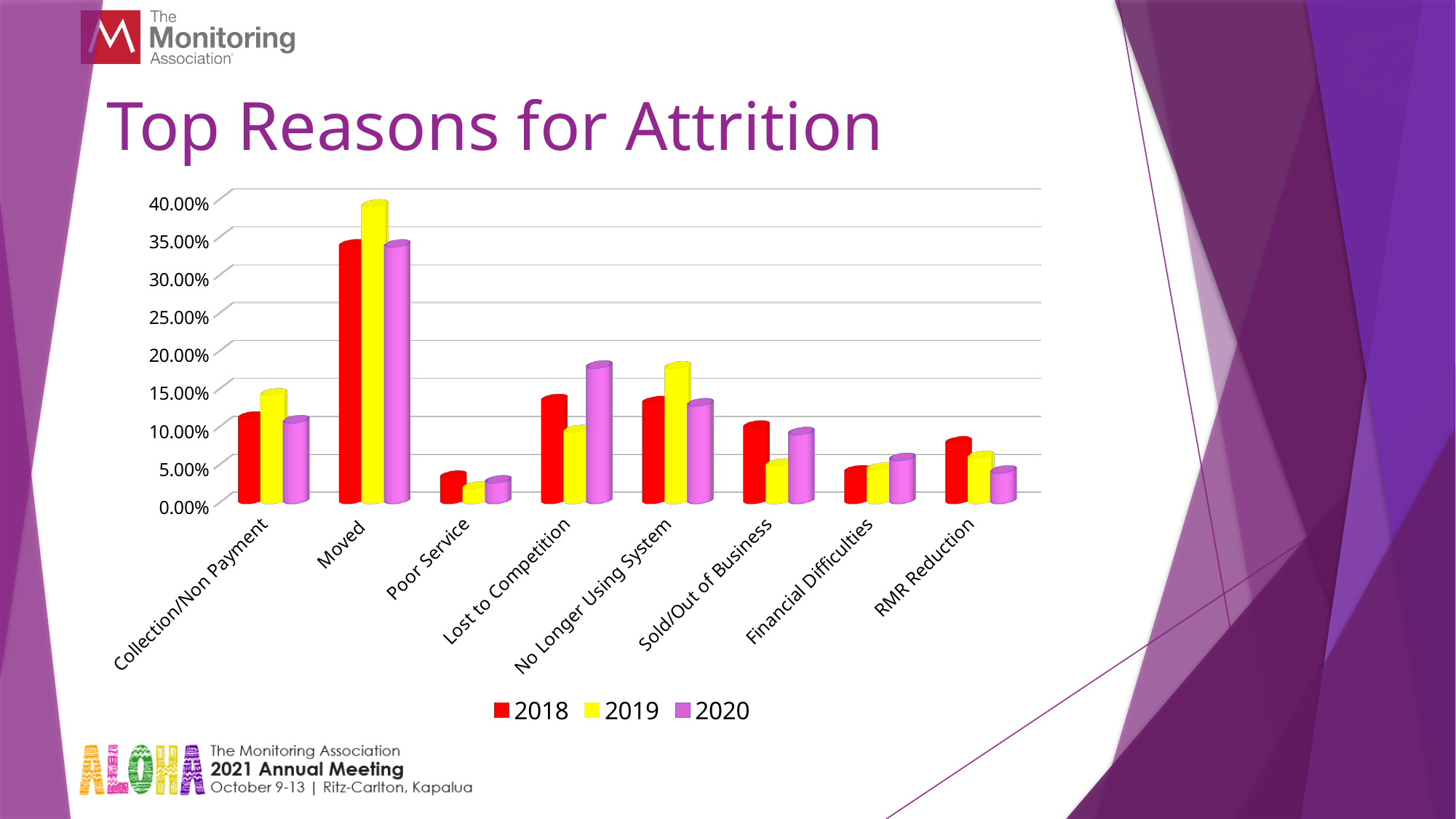
Which reason has the lowest value for 2018? Poor Service How many series does the legend list? 3 Is the 2019 value for Moved greater or less than 35.00%? greater Is the 2020 value for Lost to Competition greater or less than 15.00%? greater How many attrition reasons (categories) are shown on the x axis? 8 Which year is shown in red in the legend? 2018 For Lost to Competition, which year has the larger value, 2019 or 2020? 2020 Is the 2019 value for Sold/Out of Business greater or less than 10.00%? less For No Longer Using System, which year has the larger value, 2018 or 2019? 2019 Which reason has the highest value for 2019? Moved What kind of chart is shown on the slide? Bar chart What is the title of the slide? Top Reasons for Attrition